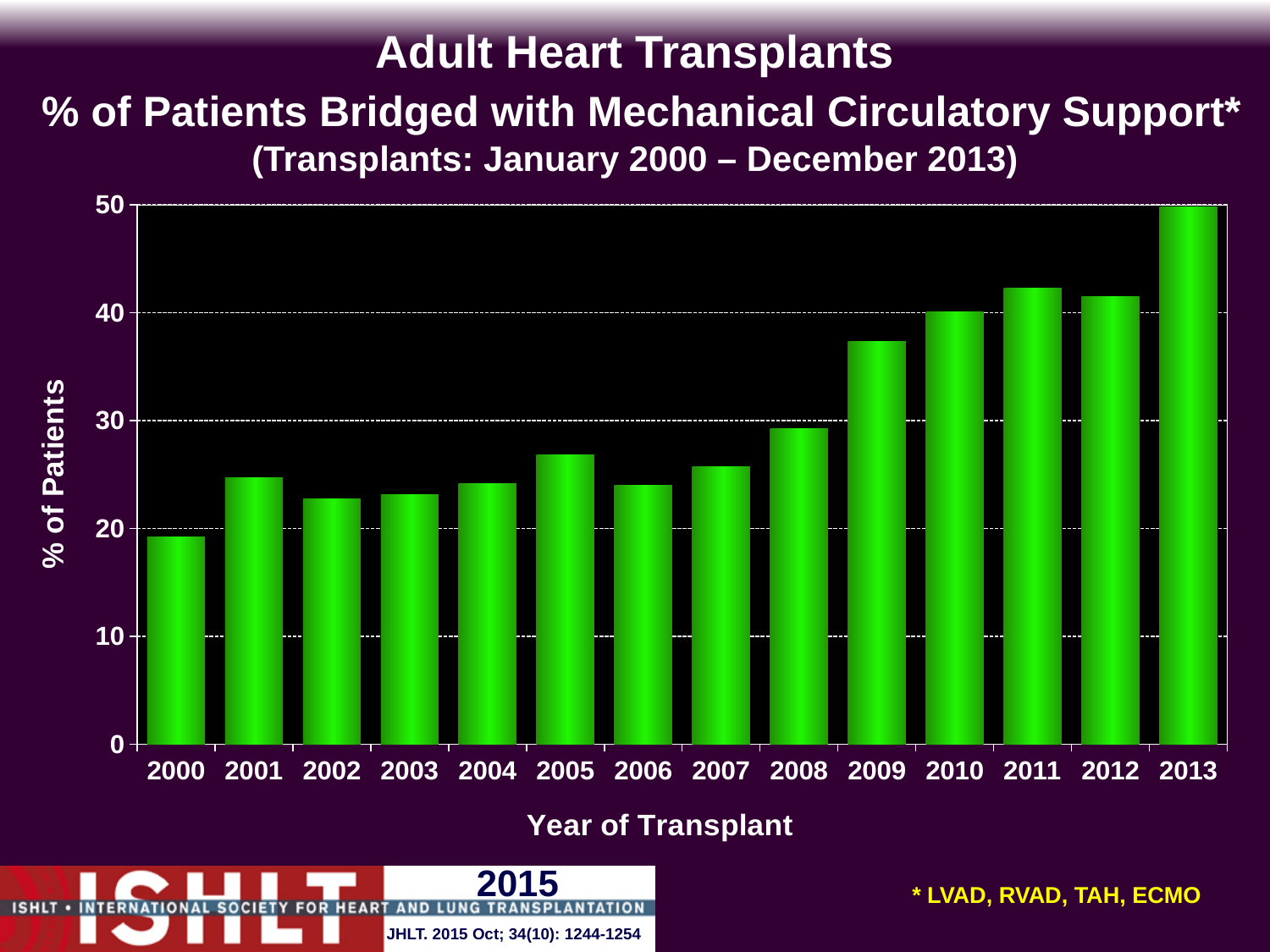
Overall, do the values rise or fall from 2000 to 2013? Rise What is the label on the y axis? % of Patients Which year has the larger value, 2008 or 2009? 2009 Is the value for 2000 greater or less than 20? less Is the value for 2009 greater or less than 30? greater How many years are plotted on the x axis? 14 Is the value for 2008 greater or less than 30? less What kind of chart is shown on the slide? Bar chart Which year has the highest % of patients bridged with mechanical circulatory support? 2013 Which year has the lowest % of patients bridged with mechanical circulatory support? 2000 Which year has the larger value, 2012 or 2013? 2013